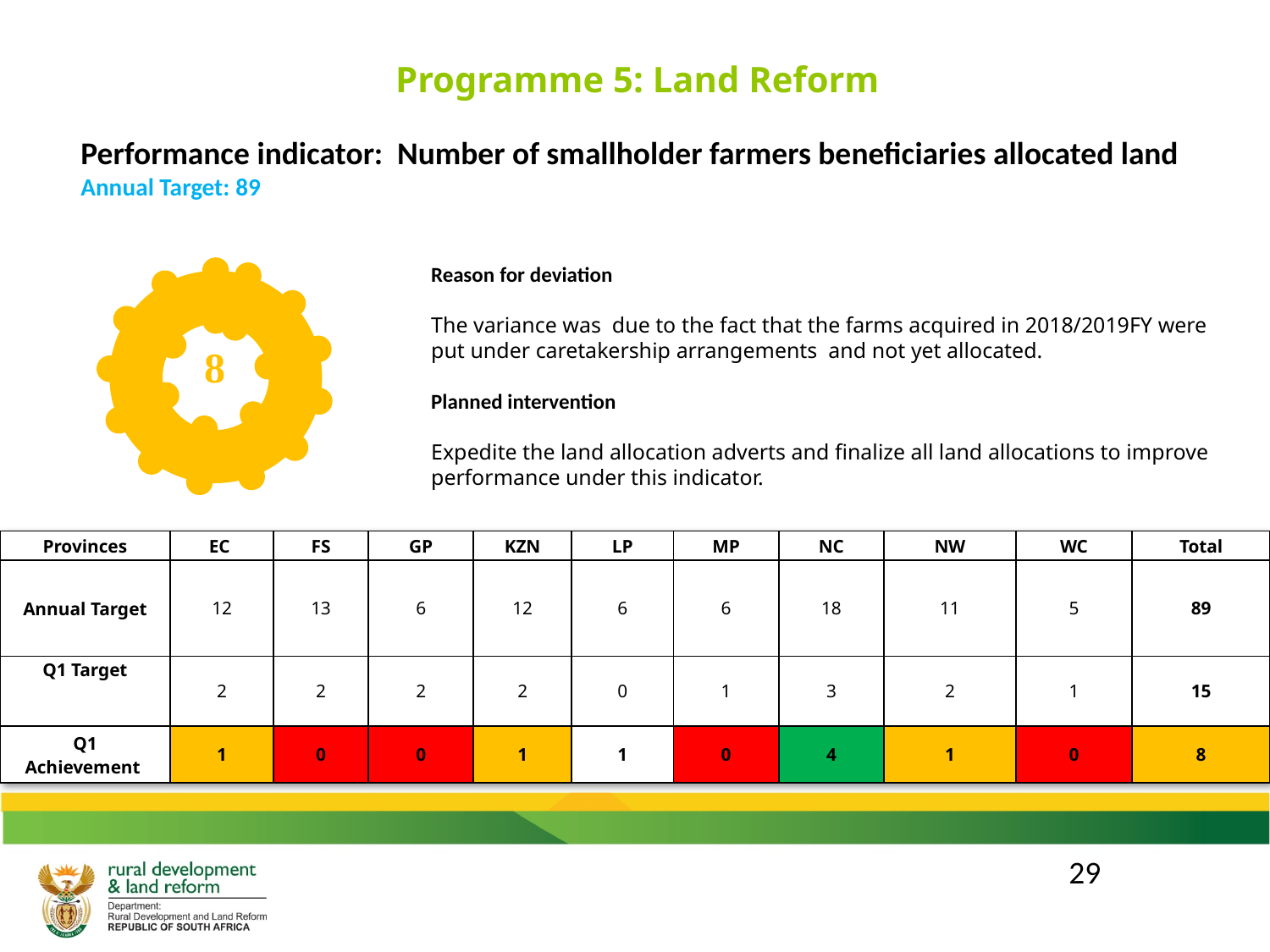
Is the value shown in the centre of the doughnut chart greater or less than 10? less In the table, which is larger, the Annual Target for FS or the Annual Target for EC? FS In the table, what is the Annual Target for NC? 18 What kind of chart is shown on the left of the slide? doughnut chart In the table, what is the Q1 Achievement for NC? 4 In the table, which province has the highest Q1 Achievement? NC In the table, what is the Total Q1 Achievement? 8 In the table, what is the Q1 Target for LP? 0 In the table, how many provinces are listed (excluding Total)? 9 What number is displayed in the centre of the doughnut chart? 8 What colour is the ring of the doughnut chart? yellow In the table, what is the difference between the Total Q1 Target and the Total Q1 Achievement? 7